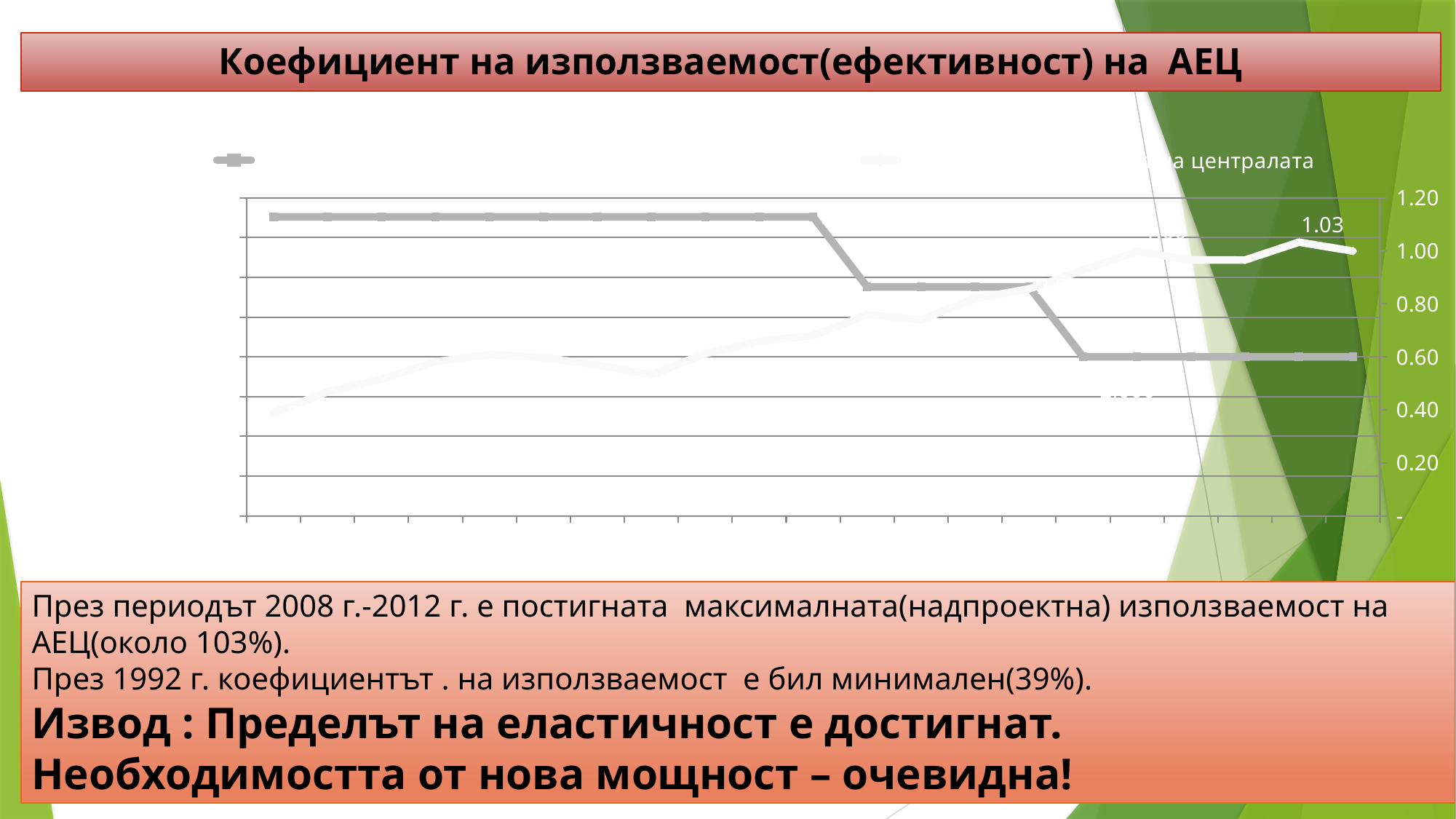
Is the value of the white line at the right end of the chart greater or less than 0.80? greater Is the value of the white line at the left end of the chart greater or less than 0.60? less How many series does the chart's legend list? 2 Does the grey stepped line rise or fall from left to right across the chart? fall Is the value of the grey stepped line at the left end of the chart greater or less than 1.00? greater What is the highest tick value shown on the vertical axis of the chart? 1.20 What kind of chart is shown on the slide? line chart At the left end of the chart, which line has the larger value, the grey stepped line or the white line? the grey stepped line What is the only data label printed on the chart? 1.03 Does the white line generally rise or fall from left to right across the chart? rise